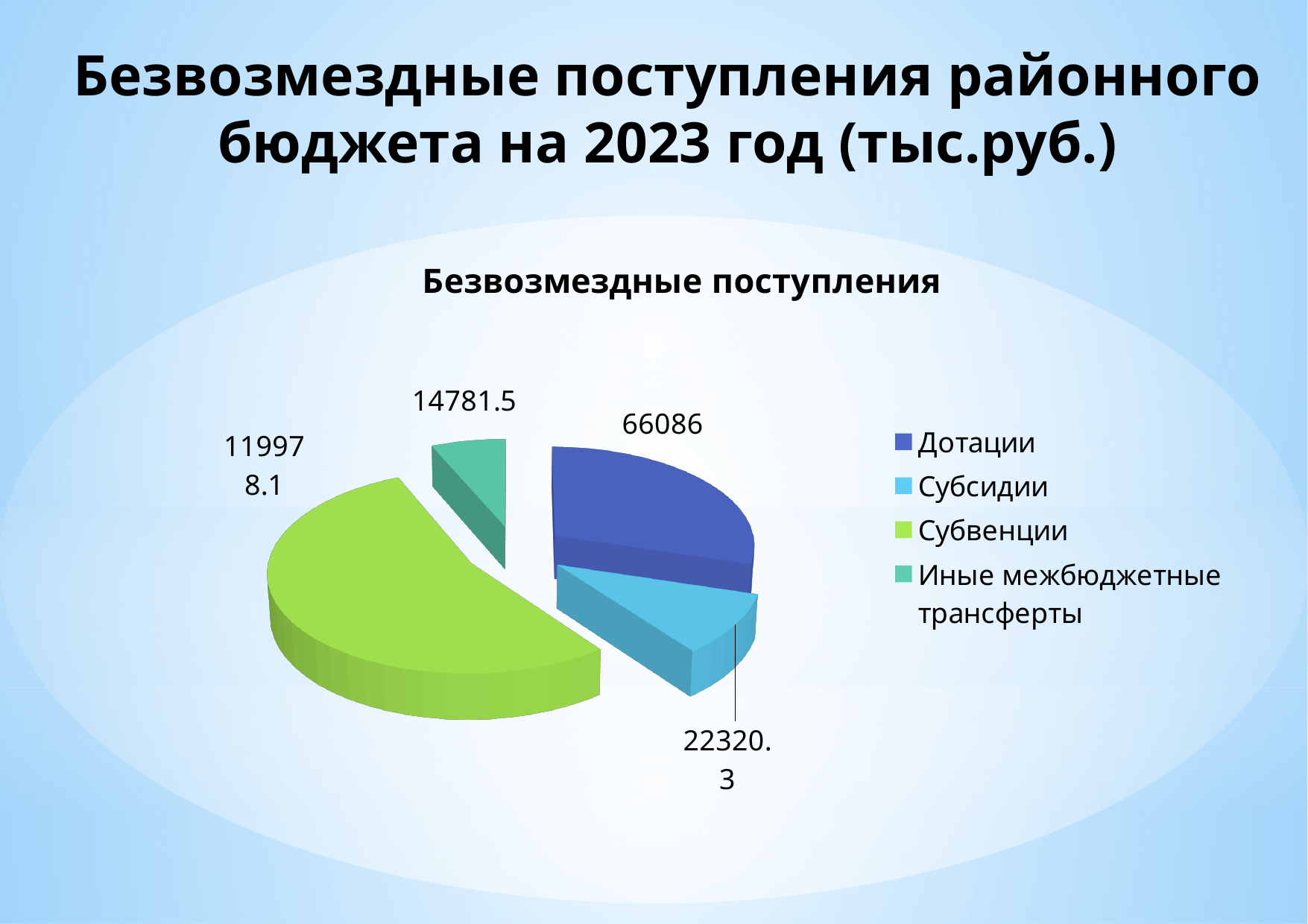
What is the value for Дотации? 66086 How many categories are shown in the pie chart? 4 What is the difference between the values for Субвенции and Дотации? 53892.1 What is the value for Иные межбюджетные трансферты? 14781.5 Which is larger, the value for Субсидии or the value for Иные межбюджетные трансферты? Субсидии What is the title of the chart? Безвозмездные поступления What kind of chart is shown on the slide? Pie chart What is the value for Субвенции? 119978.1 What is the value for Субсидии? 22320.3 Which category has the largest slice of the pie? Субвенции What is the difference between the values for Дотации and Субсидии? 43765.7 Which category has the smallest slice of the pie? Иные межбюджетные трансферты